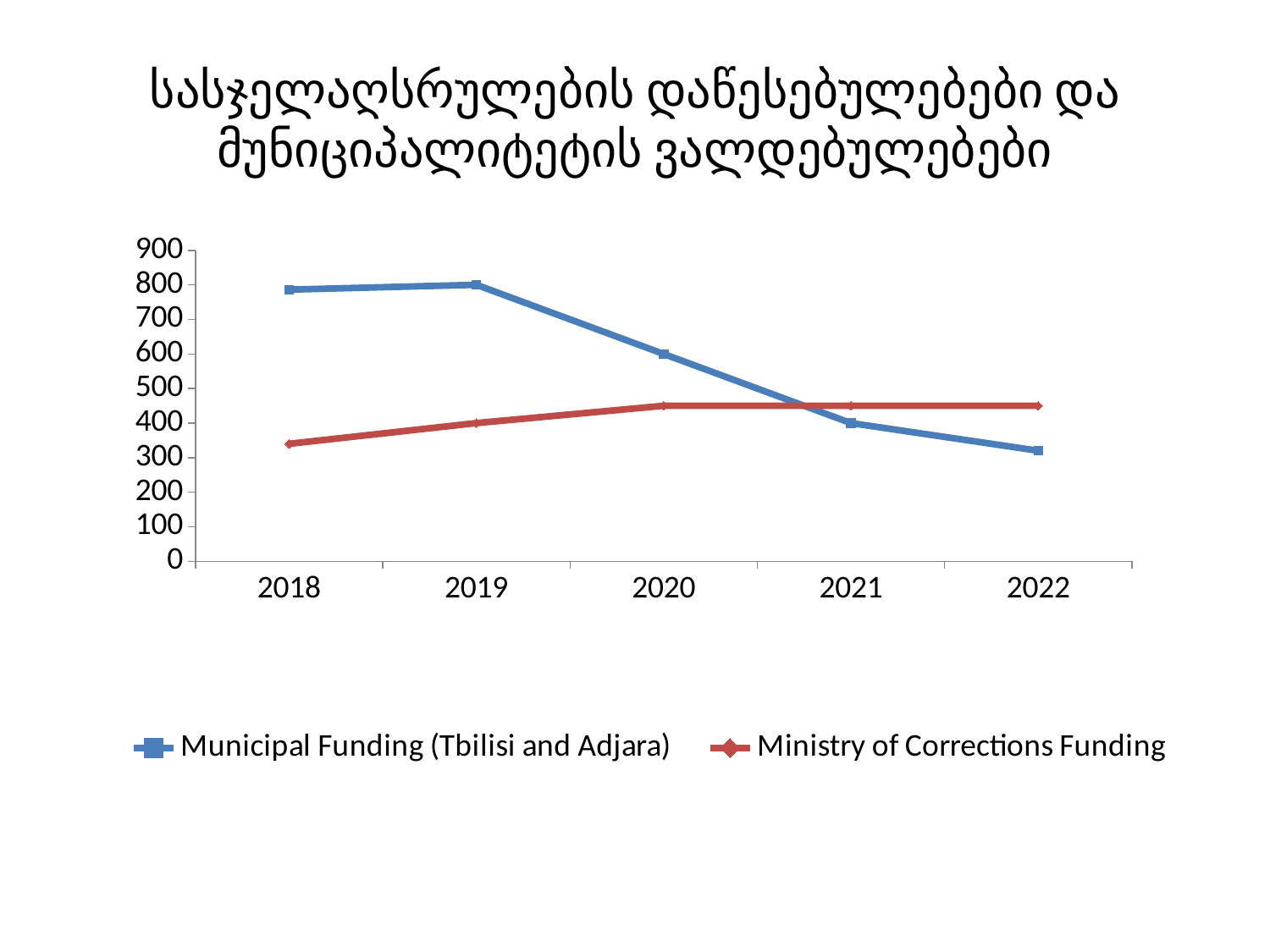
What is the value of Municipal Funding (Tbilisi and Adjara) in 2019? 800 Is the value for Ministry of Corrections Funding in 2018 greater or less than 400? less What is the difference between Municipal Funding (Tbilisi and Adjara) and Ministry of Corrections Funding in 2019? 400 Is the value for Municipal Funding (Tbilisi and Adjara) in 2018 greater or less than 700? greater Which series has the larger value in 2022, Municipal Funding (Tbilisi and Adjara) or Ministry of Corrections Funding? Ministry of Corrections Funding What is the value of Municipal Funding (Tbilisi and Adjara) in 2020? 600 What is the value of Ministry of Corrections Funding in 2019? 400 How many series does the legend list? 2 Does Municipal Funding (Tbilisi and Adjara) rise or fall from 2019 to 2022? fall What kind of chart is shown on the slide? line chart How many years are shown on the x axis? 5 In which year is Municipal Funding (Tbilisi and Adjara) lowest? 2022